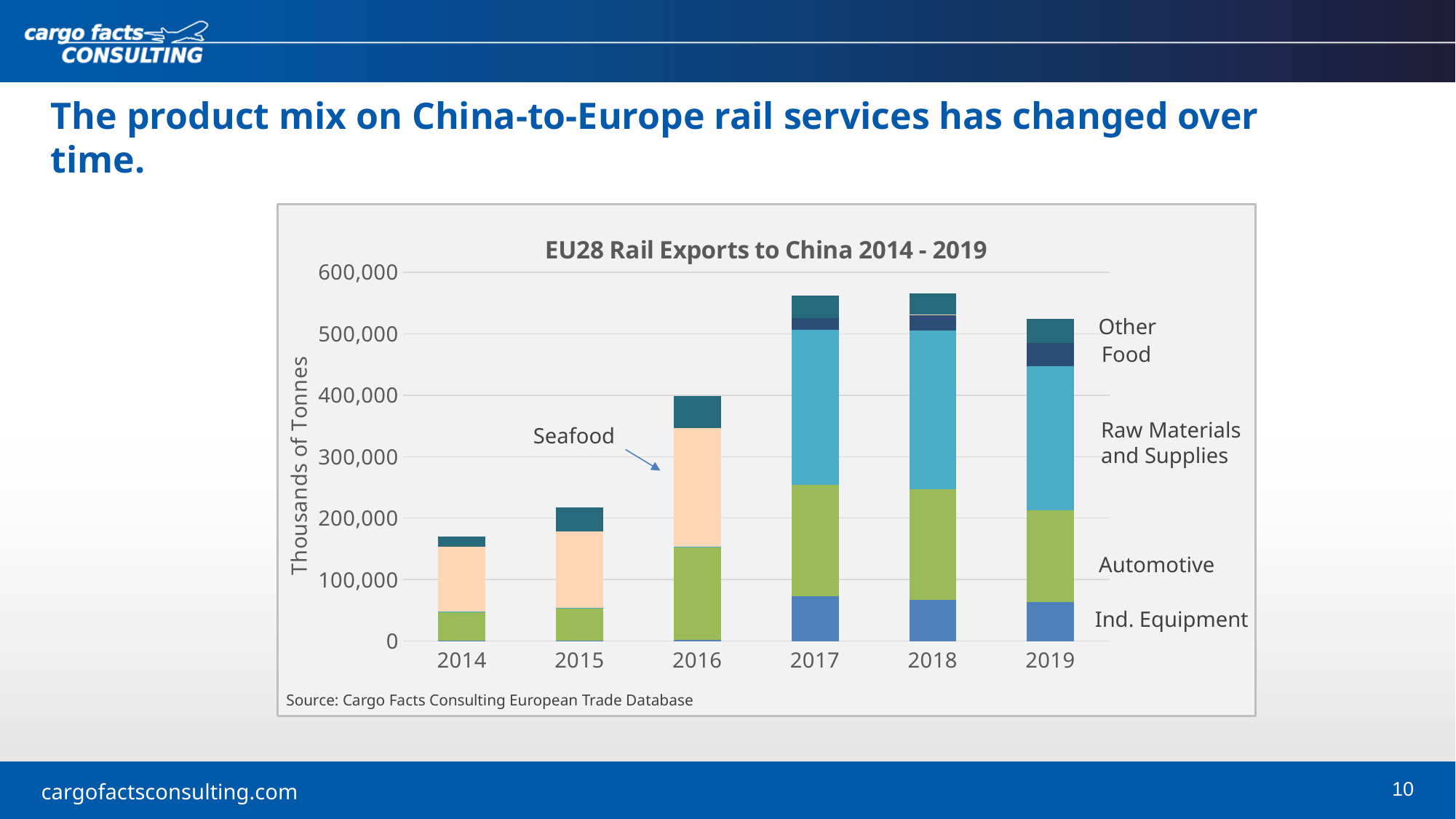
What is the title of the chart? EU28 Rail Exports to China 2014 - 2019 How many product categories are labelled on the chart? 6 Do total rail exports rise or fall from 2014 to 2017? Rise Which year has a larger total, 2016 or 2017? 2017 What unit is shown on the y axis of the chart? Thousands of Tonnes Which year has a larger total, 2018 or 2019? 2018 Is the total value for 2017 greater or less than 500,000? greater How many years are shown on the x axis of the chart? 6 Is the total value for 2019 greater or less than 500,000? greater What type of chart is shown on the slide? Stacked bar chart Is the total value for 2014 greater or less than 200,000? less Which year has the lowest total rail exports in the chart? 2014